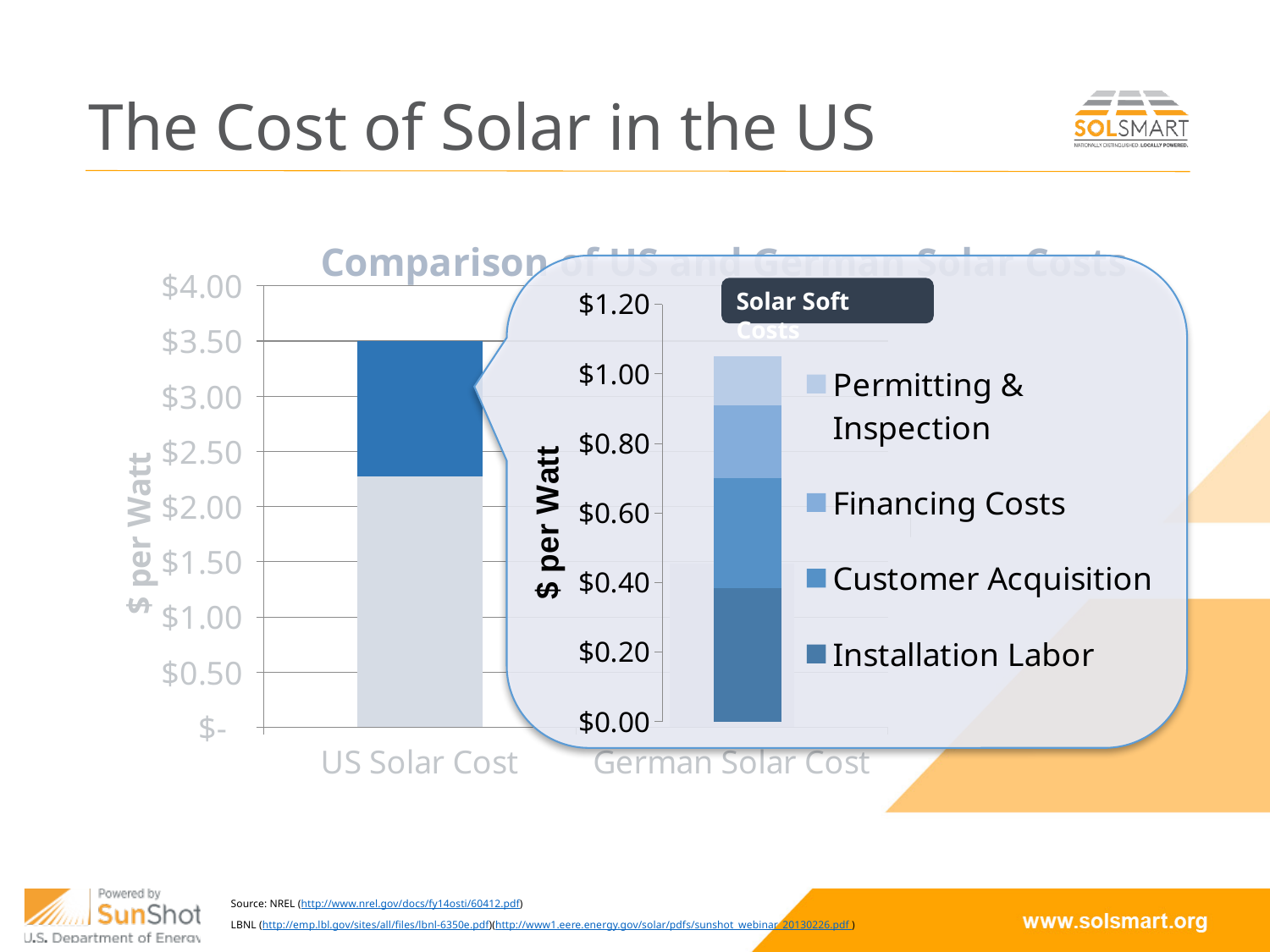
What is the y-axis title of the Comparison of US and German Solar Costs chart? $ per Watt In the Comparison of US and German Solar Costs chart, is the total US Solar Cost bar greater or less than $3.00? greater In the Solar Soft Costs chart, is the Installation Labor segment greater or less than $0.20? greater What kind of chart is the Comparison of US and German Solar Costs chart? bar chart What kind of chart is the Solar Soft Costs chart in the callout? bar chart In the Comparison of US and German Solar Costs chart, is the total US Solar Cost bar greater or less than $4.00? less How many categories are shown on the x axis of the Comparison of US and German Solar Costs chart? 2 In the Solar Soft Costs chart, which series is shown at the bottom of the stacked bar? Installation Labor In the Solar Soft Costs chart, which segment of the stacked bar is the largest? Installation Labor How many series does the legend of the Solar Soft Costs chart list? 4